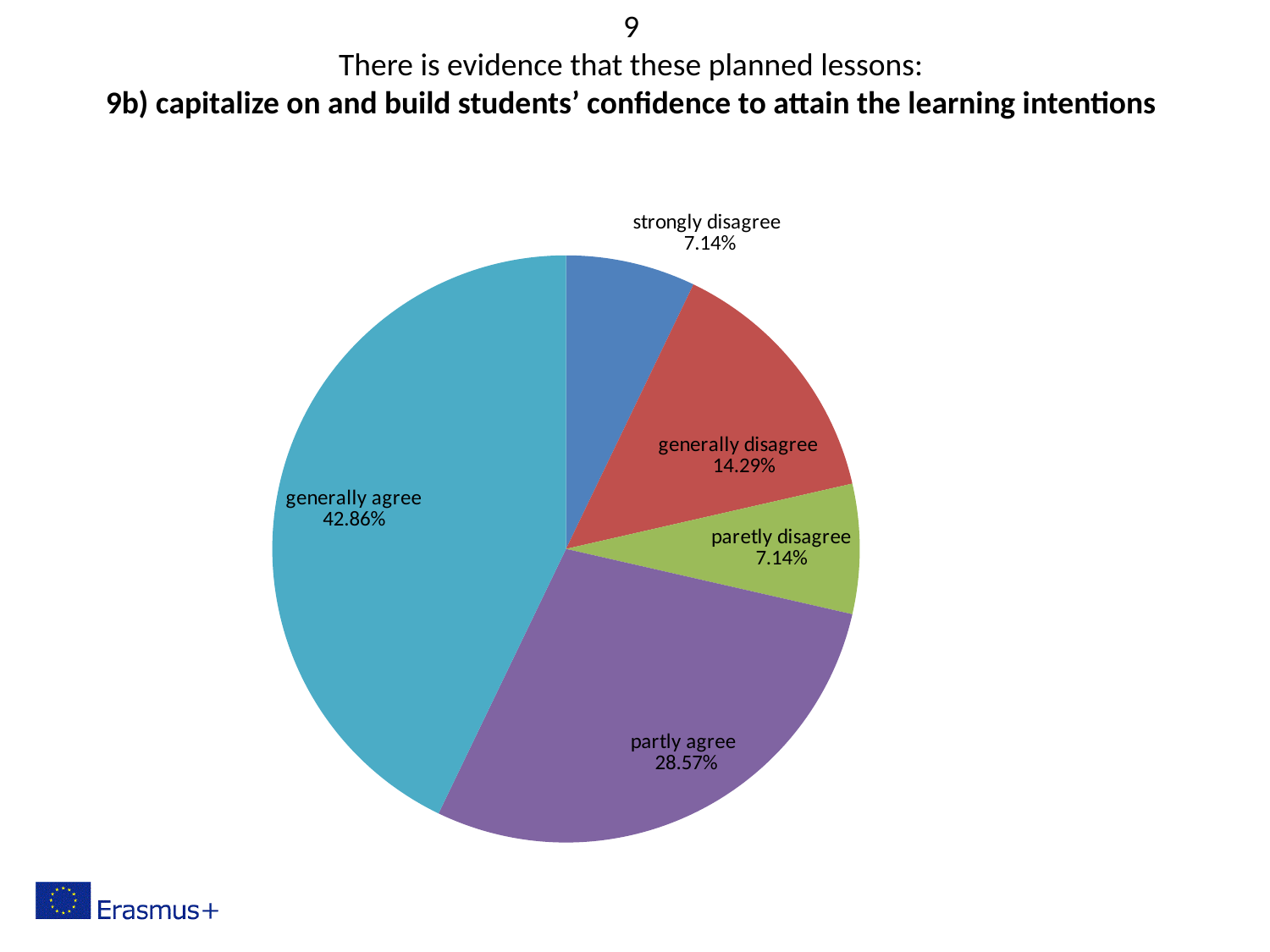
How many slices does the pie chart have? 5 What colour is the "partly agree" slice? purple What is the difference between the "generally agree" share and the "partly agree" share? 14.29% Which two slices share the same value of 7.14%? strongly disagree and paretly disagree What share of the pie is labelled "generally disagree"? 14.29% What share of the pie is labelled "generally agree"? 42.86% What share of the pie is labelled "partly agree"? 28.57% What share of the pie is labelled "strongly disagree"? 7.14% Which is larger, the "partly agree" slice or the "generally disagree" slice? partly agree What is the difference between the "generally disagree" share and the "strongly disagree" share? 7.15% What kind of chart is shown on the slide? pie chart Which slice of the pie is the largest? generally agree